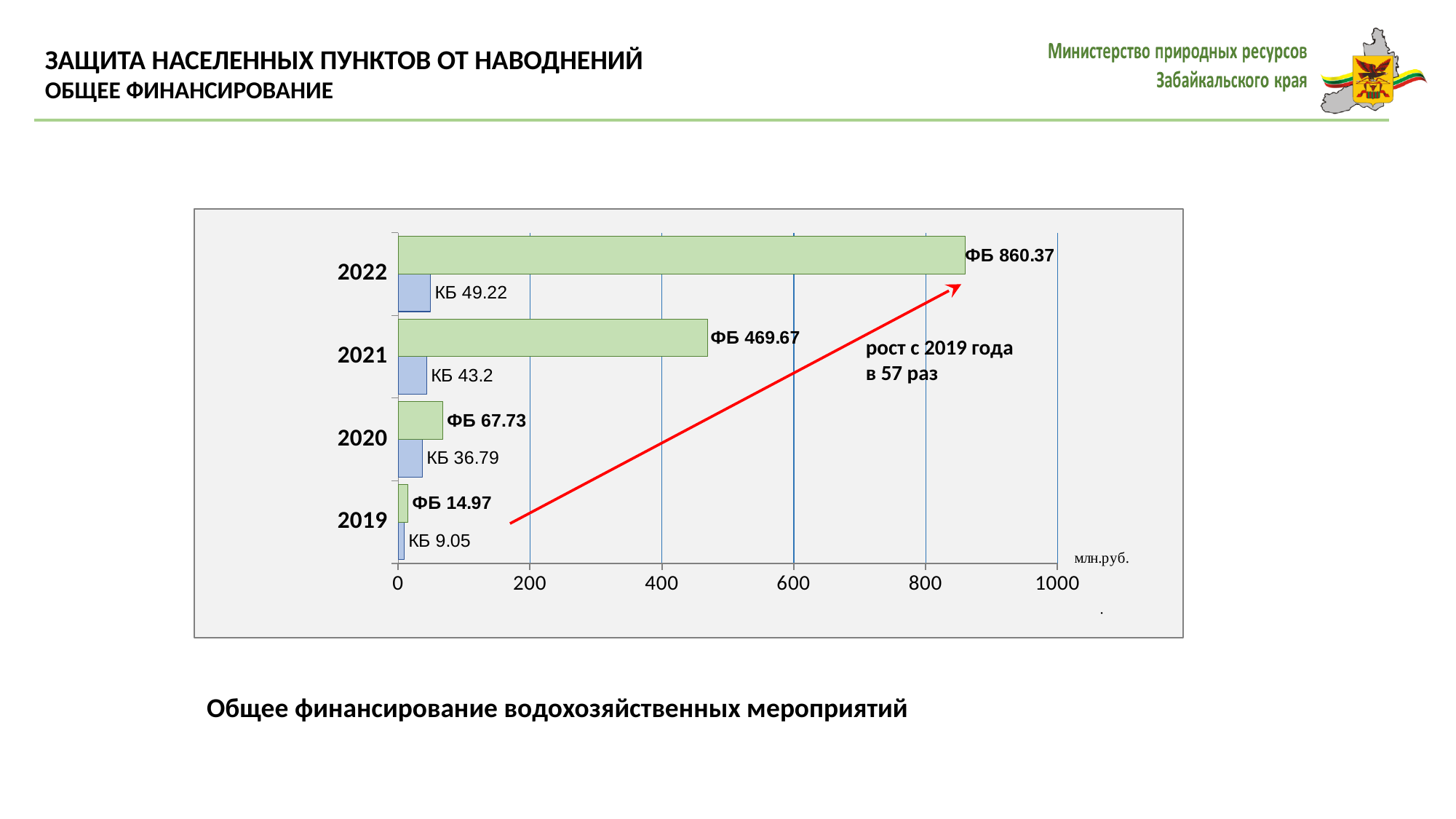
Which year has the highest ФБ value? 2022 What is the КБ value for 2020? 36.79 What is the difference between the ФБ values for 2022 and 2021? 390.7 What is the ФБ value for 2022? 860.37 What is the ФБ value for 2019? 14.97 Which is larger, the ФБ value for 2020 or the КБ value for 2020? ФБ 67.73 Which year has the lowest КБ value? 2019 How many years are shown on the chart? 4 Is the ФБ value for 2021 greater or less than 400? greater What kind of chart is shown on the slide? bar chart Do the ФБ values rise or fall from 2019 to 2022? rise What is the КБ value for 2021? 43.2